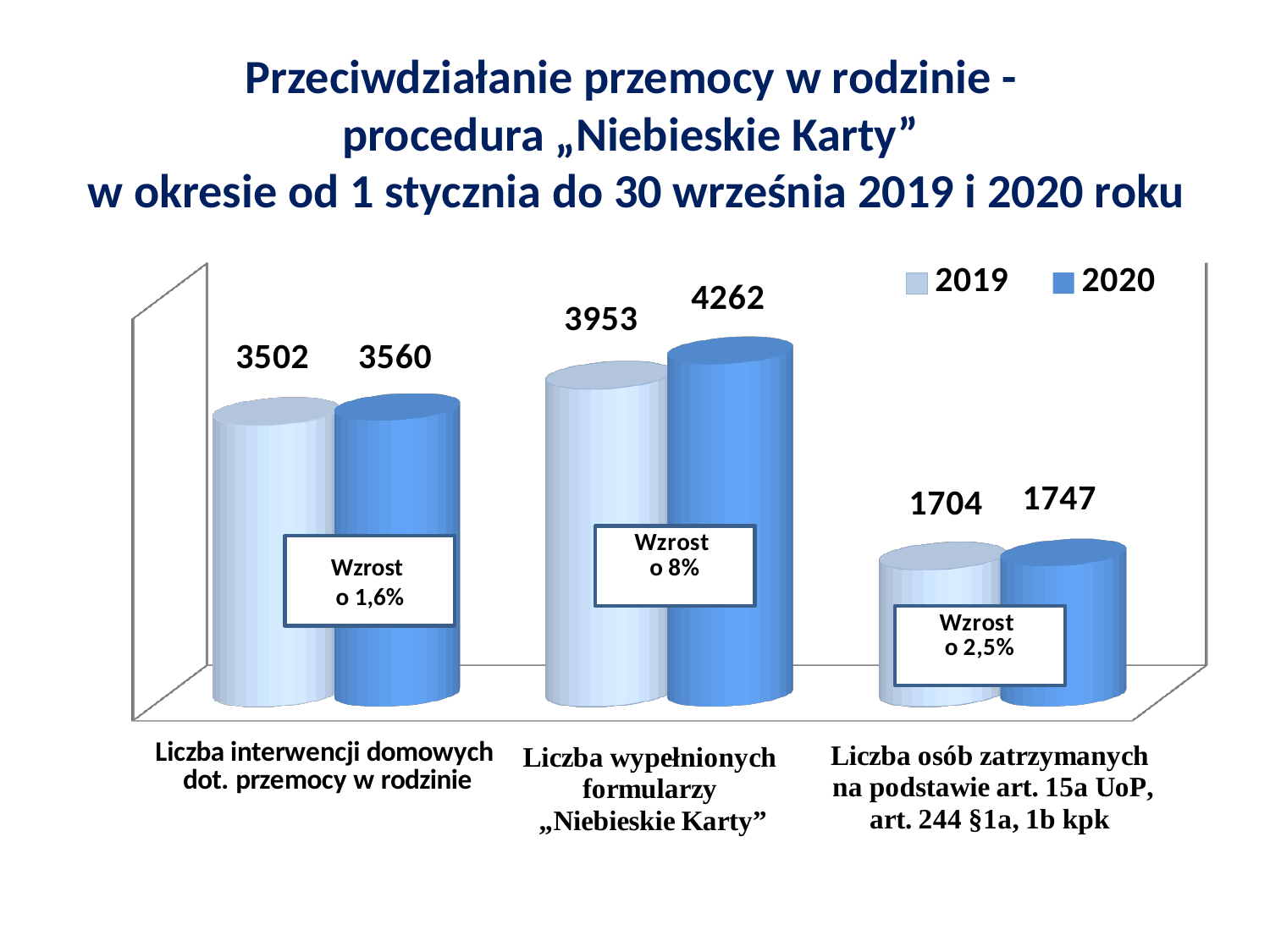
What is the 2020 value for "Liczba interwencji domowych dot. przemocy w rodzinie"? 3560 Which is larger: the 2019 value for "Liczba interwencji domowych dot. przemocy w rodzinie" or the 2019 value for "Liczba wypełnionych formularzy „Niebieskie Karty”"? Liczba wypełnionych formularzy „Niebieskie Karty” What percentage increase is shown in the box for "Liczba wypełnionych formularzy „Niebieskie Karty”"? Wzrost o 8% What is the difference between the 2020 and 2019 values for "Liczba osób zatrzymanych na podstawie art. 15a UoP, art. 244 §1a, 1b kpk"? 43 How many categories are shown on the chart? 3 Which category has the lowest 2019 value? Liczba osób zatrzymanych na podstawie art. 15a UoP, art. 244 §1a, 1b kpk How many series does the legend list? 2 Which category has the highest 2020 value? Liczba wypełnionych formularzy „Niebieskie Karty” What is the 2019 value for "Liczba osób zatrzymanych na podstawie art. 15a UoP, art. 244 §1a, 1b kpk"? 1704 What is the 2019 value for "Liczba interwencji domowych dot. przemocy w rodzinie"? 3502 What is the 2020 value for "Liczba wypełnionych formularzy „Niebieskie Karty”"? 4262 What is the difference between the 2020 and 2019 values for "Liczba wypełnionych formularzy „Niebieskie Karty”"? 309